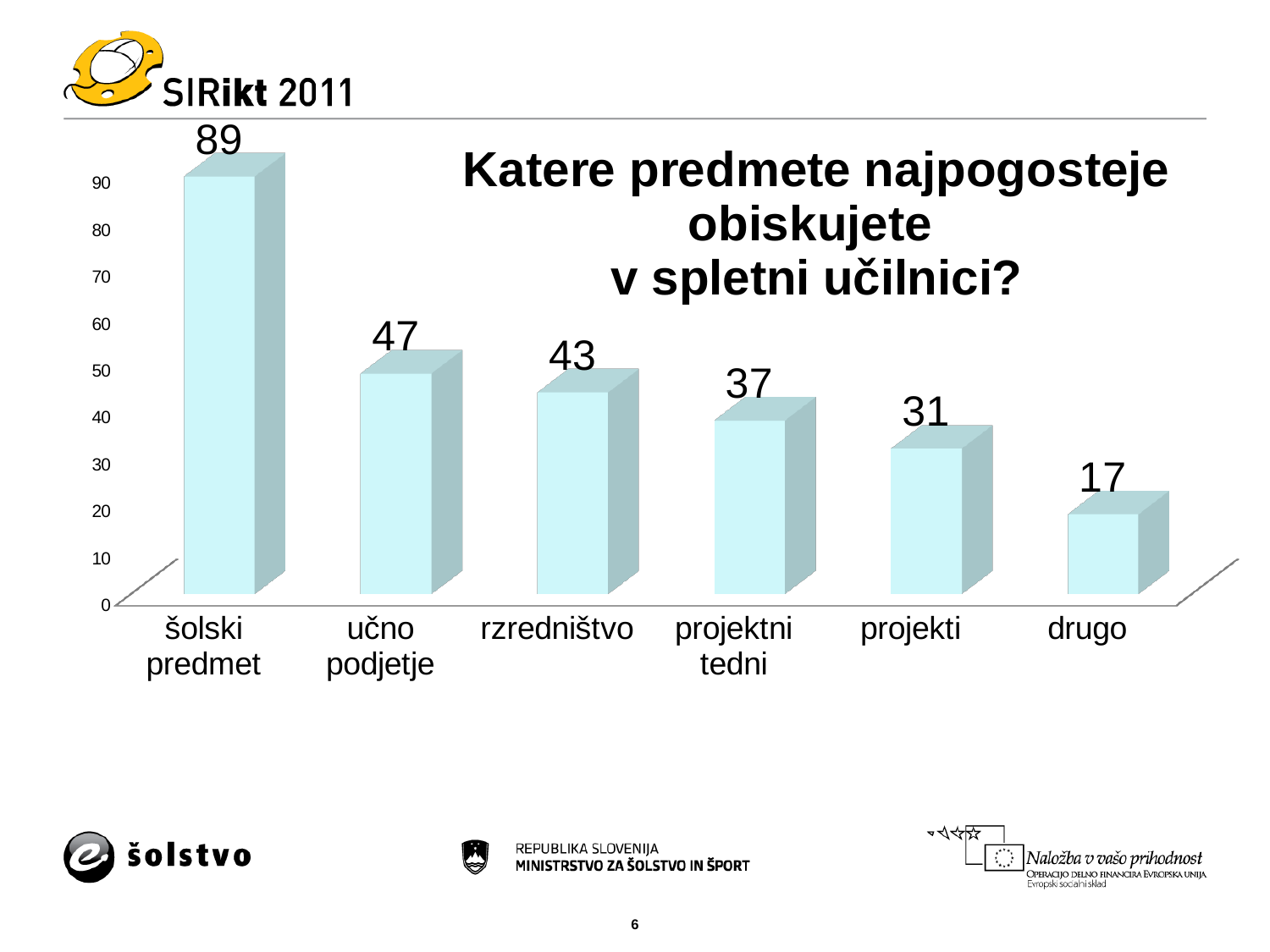
Which category has the lowest value? drugo What is the value for projektni tedni? 37 What is the value for drugo? 17 Do the values rise or fall from left to right along the x axis? fall Which category has the highest value? šolski predmet What is the difference between the values for šolski predmet and učno podjetje? 42 How many categories are shown on the x axis? 6 What is the value for učno podjetje? 47 Which is larger, the value for rzredništvo or the value for projektni tedni? rzredništvo What kind of chart is shown on the slide? bar chart What is the value for šolski predmet? 89 What is the difference between the values for rzredništvo and projekti? 12